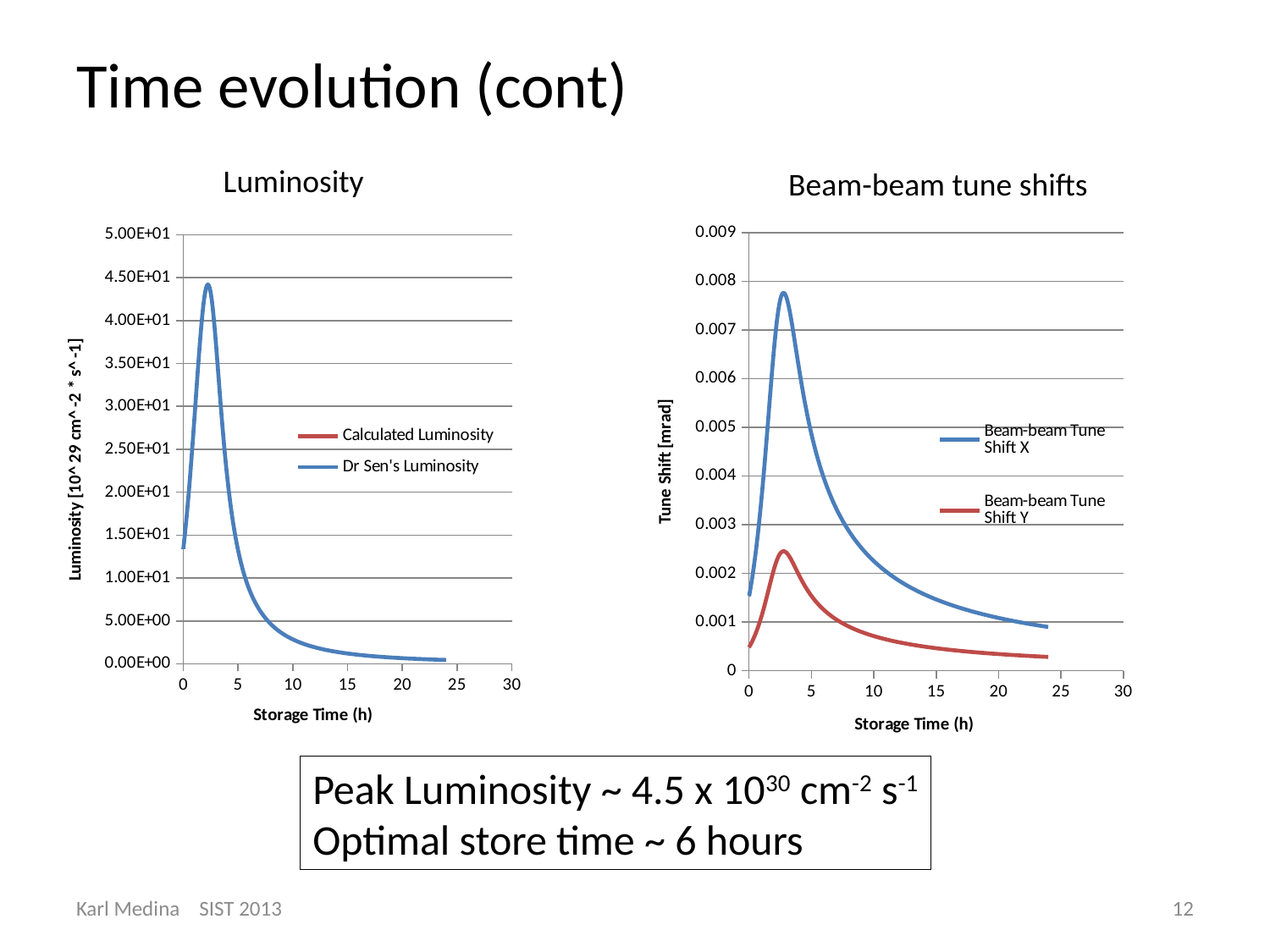
What is the y-axis label of the Beam-beam tune shifts chart? Tune Shift [mrad] In the Luminosity chart, is the luminosity at a storage time of 15 h greater or less than 5.00E+00? less In the Beam-beam tune shifts chart, which series has the higher peak value, Beam-beam Tune Shift X or Beam-beam Tune Shift Y? Beam-beam Tune Shift X In the Beam-beam tune shifts chart, is the peak value of Beam-beam Tune Shift X greater or less than 0.007? greater What kind of chart is the Beam-beam tune shifts chart? line chart What is the x-axis label of the Luminosity chart? Storage Time (h) How many series does the legend of the Beam-beam tune shifts chart list? 2 What kind of chart is the Luminosity chart? line chart In the Beam-beam tune shifts chart, is the peak value of Beam-beam Tune Shift Y greater or less than 0.003? less How many series does the legend of the Luminosity chart list? 2 In the Beam-beam tune shifts chart, do the tune shift values rise or fall as storage time increases from 5 h to 25 h? fall